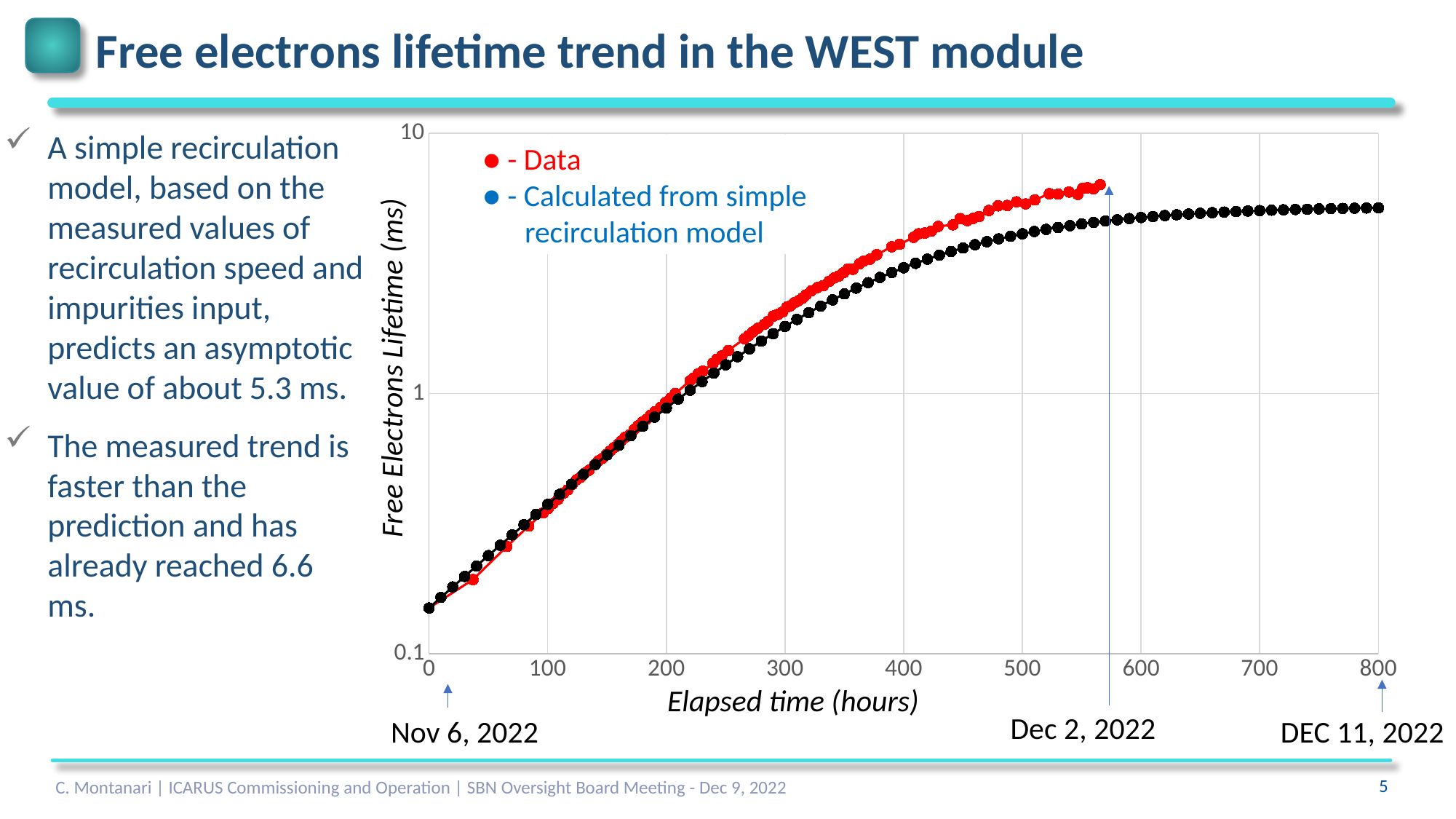
How many series does the chart's legend list? 2 Is the Data value at 400 hours greater or less than 1? greater What are the two series named in the chart's legend? Data; Calculated from simple recirculation model What kind of chart is shown on the slide? Scatter (line) chart Which series extends to the largest elapsed time on the chart? Calculated from simple recirculation model What is the label of the chart's x axis? Elapsed time (hours) Do the Data values rise or fall as elapsed time increases? Rise Is the Data value at 300 hours greater or less than 1? greater Is the value calculated from the simple recirculation model at 100 hours greater or less than 1? less At 500 hours, which series has the larger value: Data or Calculated from simple recirculation model? Data